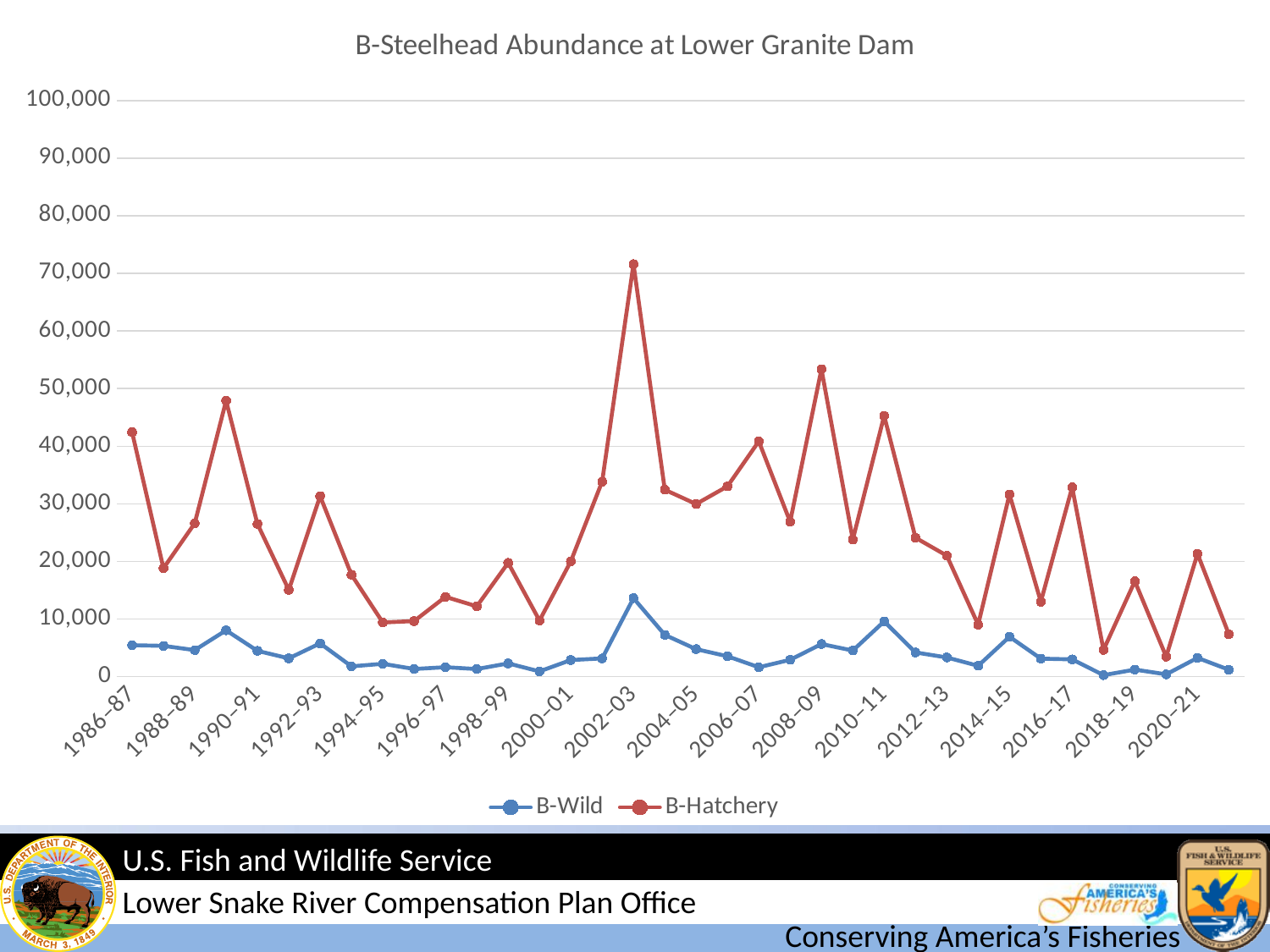
How many series does the legend list? 2 What is the title of the chart? B-Steelhead Abundance at Lower Granite Dam Which series has the larger value in 2008–09, B-Wild or B-Hatchery? B-Hatchery Is the B-Wild value for 2002–03 greater or less than 10,000? greater What kind of chart is shown on the slide? line chart For the B-Hatchery series, which year has the larger value, 1986–87 or 1988–89? 1986–87 Which colour is used for the B-Hatchery series? red In which year does the B-Hatchery series reach its highest value? 2002–03 In which year does the B-Wild series reach its highest value? 2002–03 Is the B-Hatchery value for 1994–95 greater or less than 10,000? less